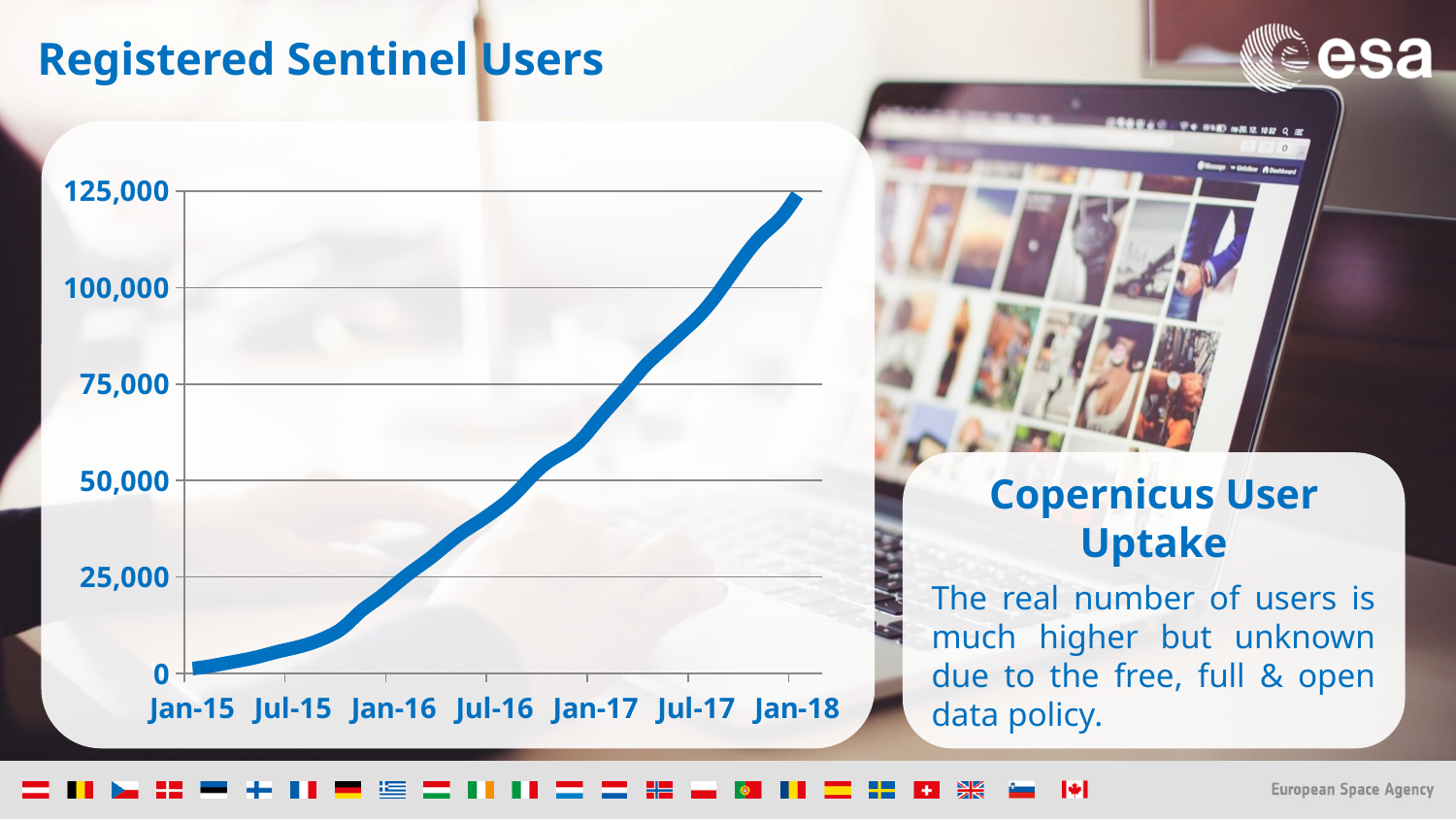
How many date labels are shown on the x axis? 7 Is the value for Jan-18 greater or less than 100,000? greater Which has the larger value, Jul-16 or Jul-17? Jul-17 Do the values rise or fall from Jan-15 to Jan-18? rise Is the value for Jul-17 greater or less than 75,000? greater At which x-axis label is the number of registered users lowest? Jan-15 What kind of chart is shown on the slide? line chart What is the title of the chart? Registered Sentinel Users At which x-axis label is the number of registered users highest? Jan-18 Is the value for Jan-17 greater or less than 50,000? greater